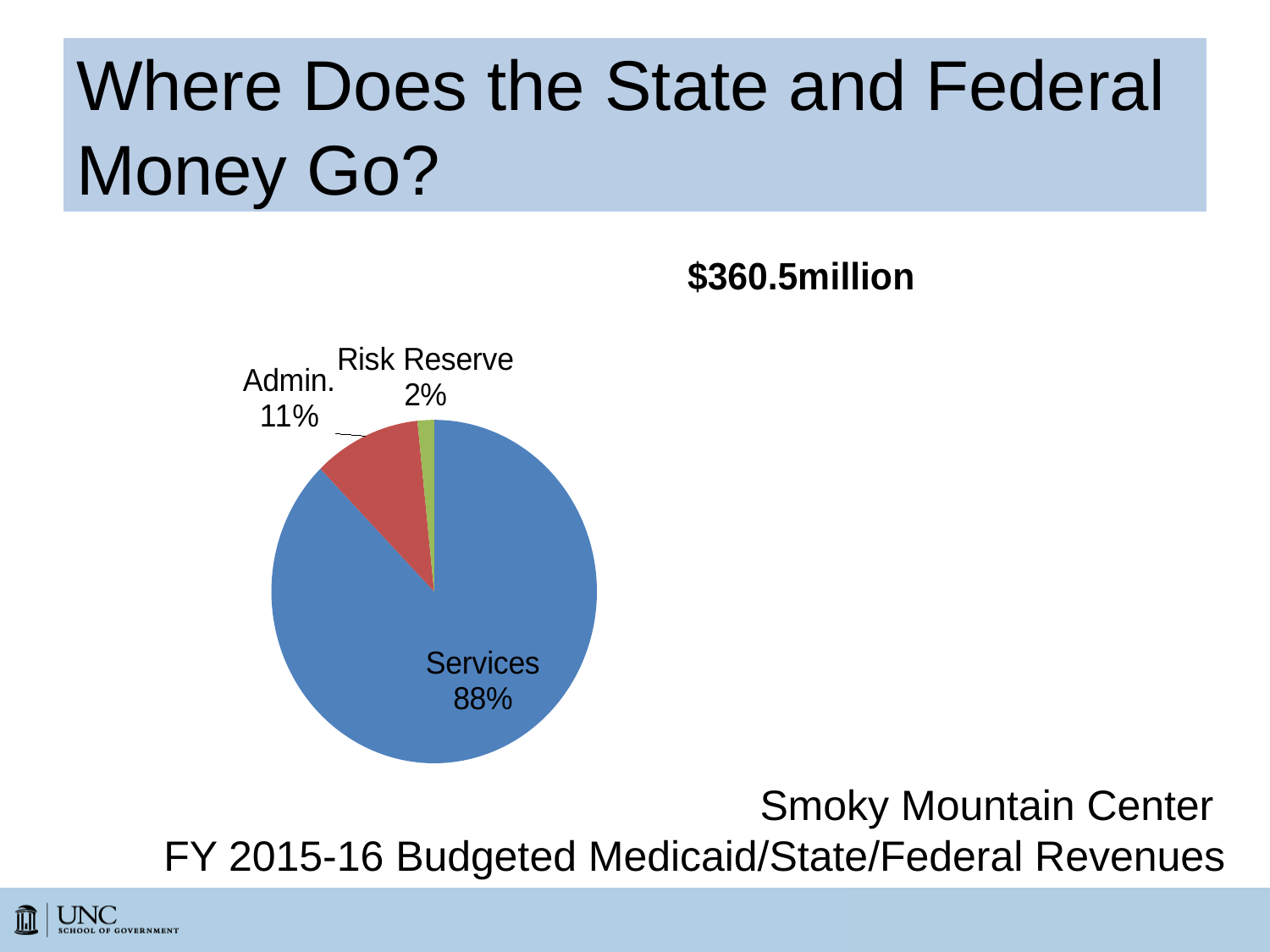
How many slices does the pie chart have? 3 What kind of chart is shown on the slide? pie chart What is the difference in percentage points between the Services slice and the Admin. slice? 77 What is the difference in percentage points between the Admin. slice and the Risk Reserve slice? 9 Which is larger, the Admin. slice or the Risk Reserve slice? Admin. What share of the pie does Risk Reserve represent? 2% What total dollar amount is shown above the pie chart? $360.5million What share of the pie does Admin. represent? 11% What colour is the Services slice of the pie? blue Which slice of the pie is the smallest? Risk Reserve Which slice of the pie is the largest? Services What share of the pie does Services represent? 88%